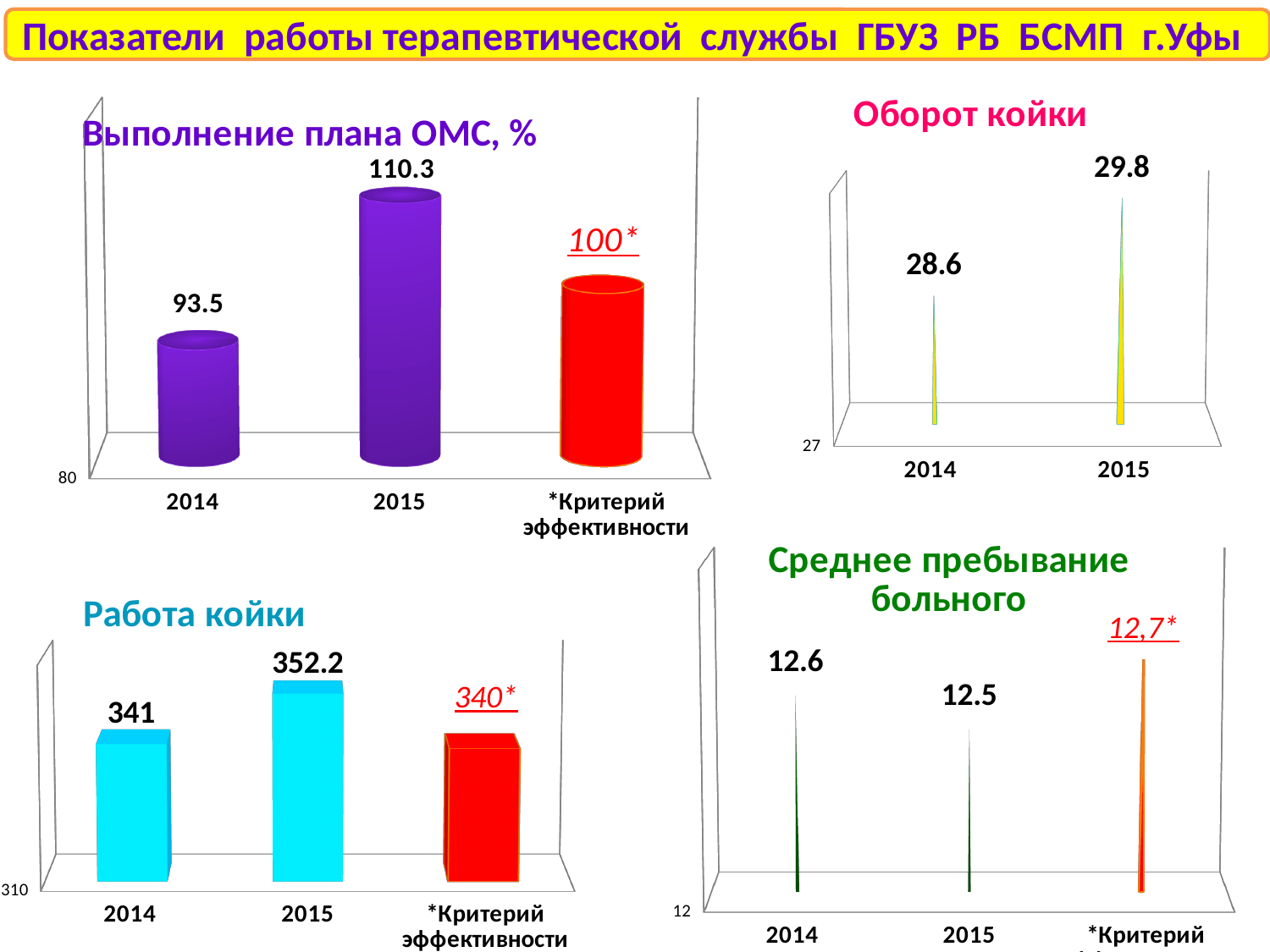
In the chart titled "Работа койки", which category has the highest value? 2015 In the chart titled "Оборот койки", what is the value for 2015? 29.8 In the chart titled "Оборот койки", which year has the lower value? 2014 In the chart titled "Выполнение плана ОМС, %", what is the value for 2014? 93.5 In the chart titled "Оборот койки", how many bars are plotted? 2 In the chart titled "Выполнение плана ОМС, %", what is the difference between the 2015 and 2014 values? 16.8 In the chart titled "Среднее пребывание больного", is the value for 2014 larger or smaller than the value for 2015? larger In the chart titled "Работа койки", what is the value for 2014? 341 In the chart titled "Выполнение плана ОМС, %", what is the value shown for the "*Критерий эффективности" bar? 100* In the chart titled "Выполнение плана ОМС, %", what is the value for 2015? 110.3 What kind of chart is the one titled "Работа койки"? bar chart In the chart titled "Среднее пребывание больного", what is the value for 2015? 12.5